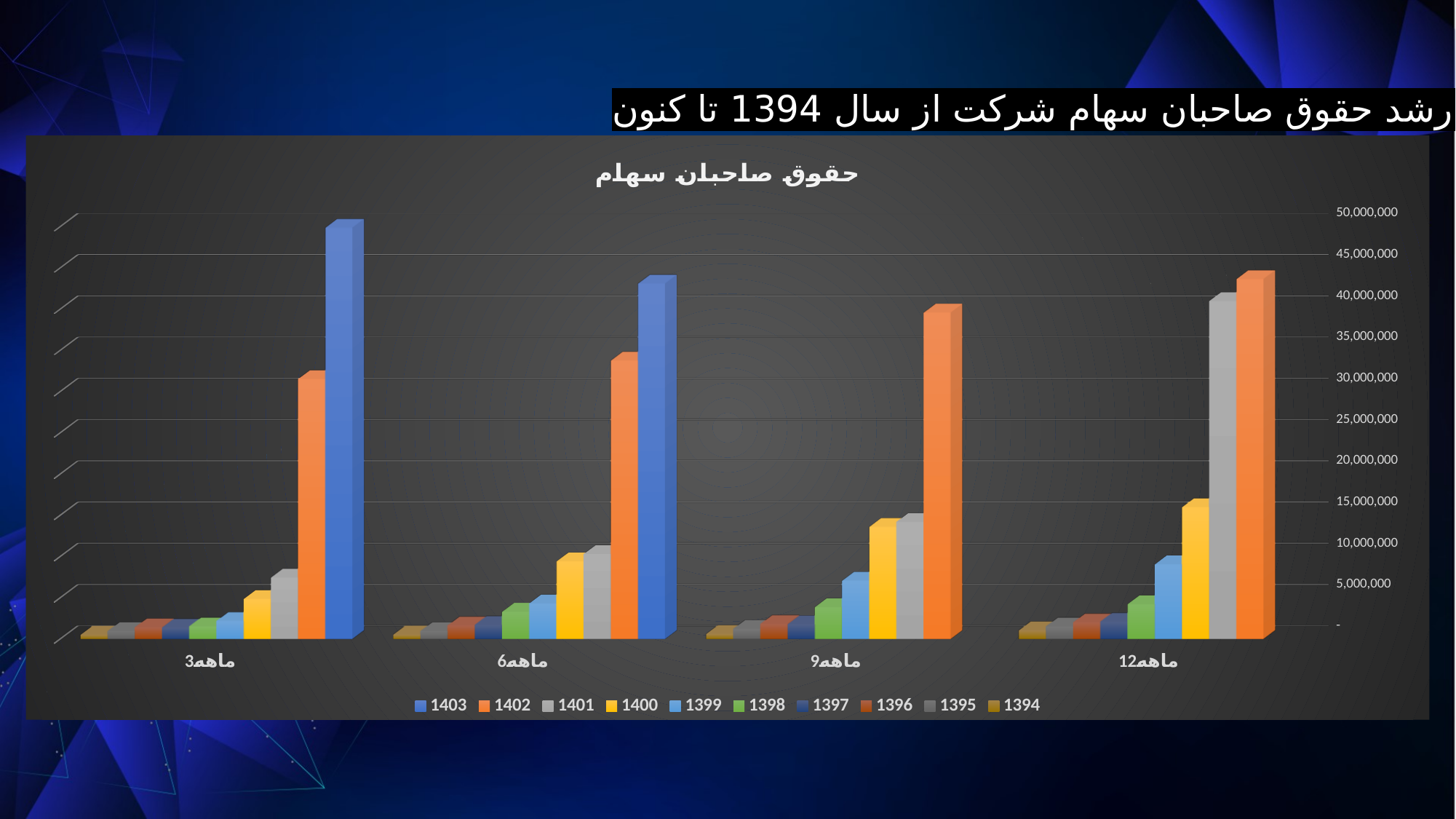
Is the value for series 1403 in the 3ماهه category greater or less than 45,000,000? greater Is the value for series 1399 in the 12ماهه category greater or less than 10,000,000? less Is the value for series 1402 in the 6ماهه category greater or less than 30,000,000? greater In the 6ماهه category, which is larger: the value for series 1400 or series 1399? 1400 How many series does the chart legend list? 10 Which series has the tallest bar in the 3ماهه category? 1403 In the 3ماهه category, which is larger: the value for series 1403 or series 1402? 1403 What is the title of the chart? حقوق صاحبان سهام What kind of chart is shown on the slide? bar chart How many categories are shown on the x axis of the chart? 4 Do the values for series 1402 rise or fall from 3ماهه to 12ماهه? rise